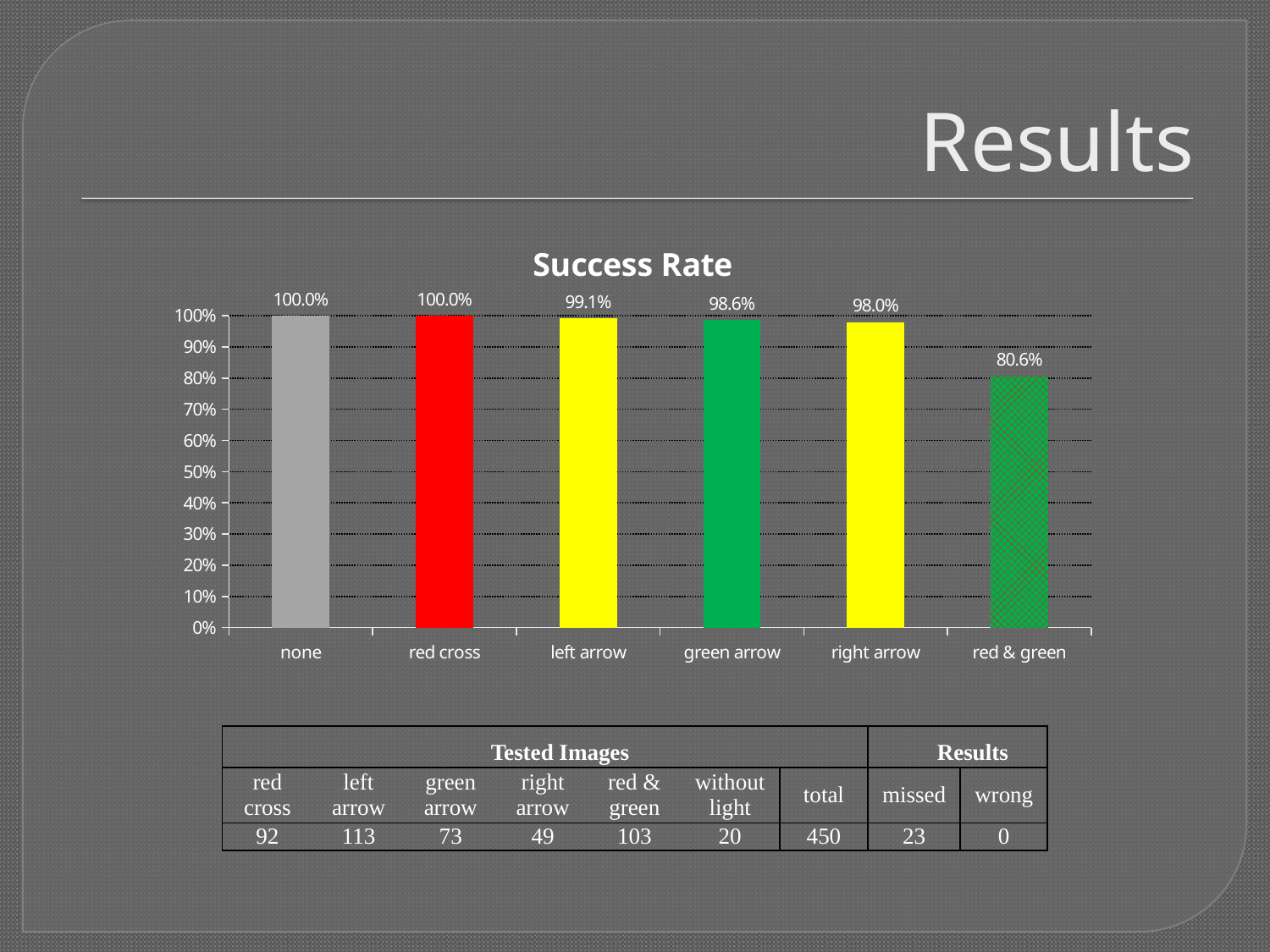
What is the title of the chart? Success Rate What kind of chart is shown on the slide? bar chart How many categories are shown on the x axis of the chart? 6 Which has a higher success rate, green arrow or red & green? green arrow What is the success rate for left arrow? 99.1% What is the success rate for green arrow? 98.6% Is the success rate for red & green greater or less than 90%? less What is the success rate for right arrow? 98.0% What is the difference between the success rates for right arrow and red & green? 17.4% What is the difference between the success rates for left arrow and green arrow? 0.5% What is the success rate for red & green? 80.6% Which category has the lowest success rate? red & green